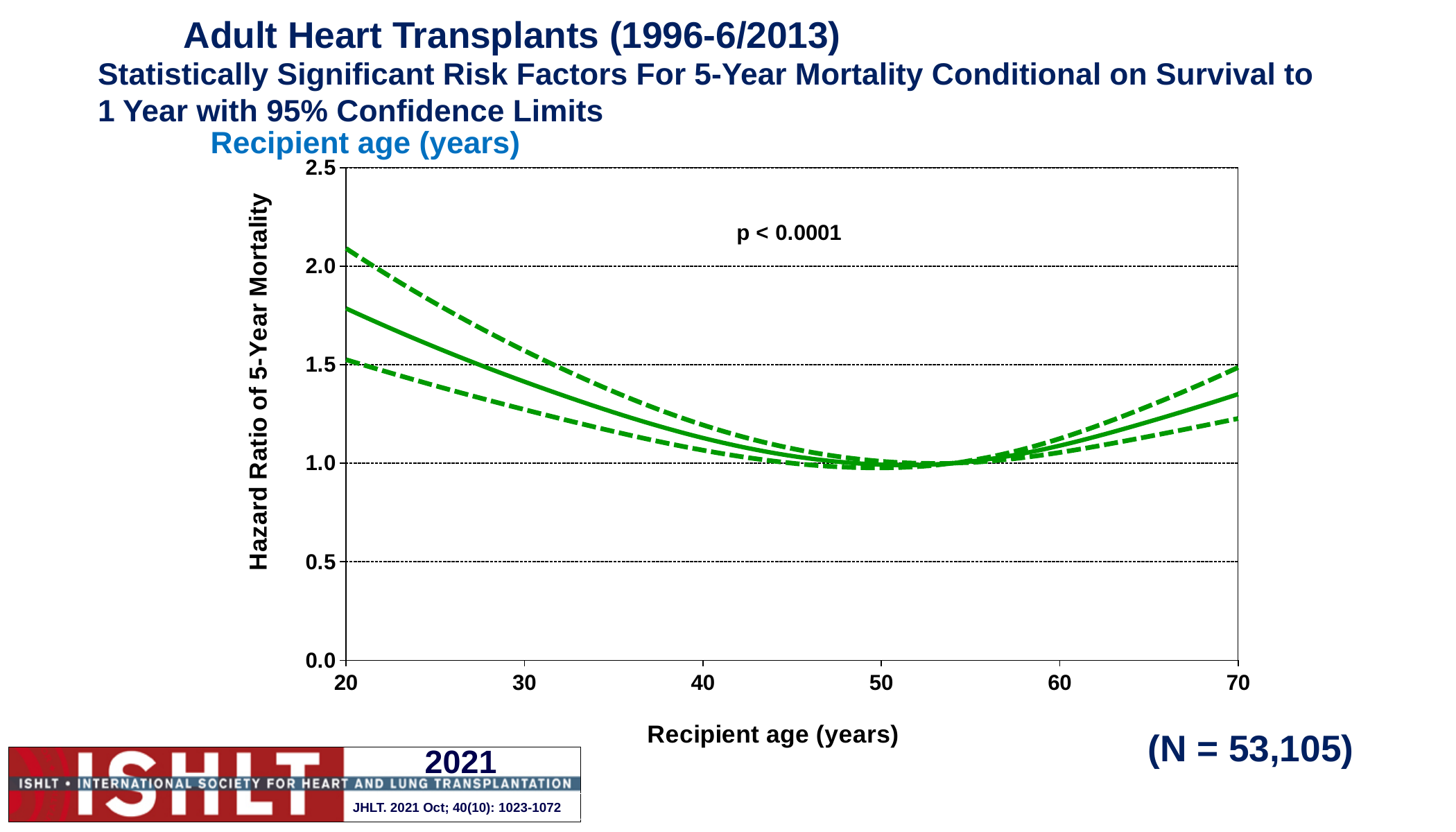
What kind of chart is shown on the slide? line chart Is the hazard ratio on the solid line higher at recipient age 20 or at recipient age 70? age 20 Is the upper dashed confidence limit at recipient age 20 greater or less than 1.5? greater Is the hazard ratio on the solid line at recipient age 40 greater or less than 1.5? less What is the label of the y axis? Hazard Ratio of 5-Year Mortality Does the solid hazard ratio line rise or fall as recipient age increases from 55 to 70? rise What is the label of the x axis? Recipient age (years) Is the lower dashed confidence limit at recipient age 70 greater or less than 1.0? greater Does the solid hazard ratio line rise or fall as recipient age increases from 20 to 50? fall How many lines are plotted on the chart? 3